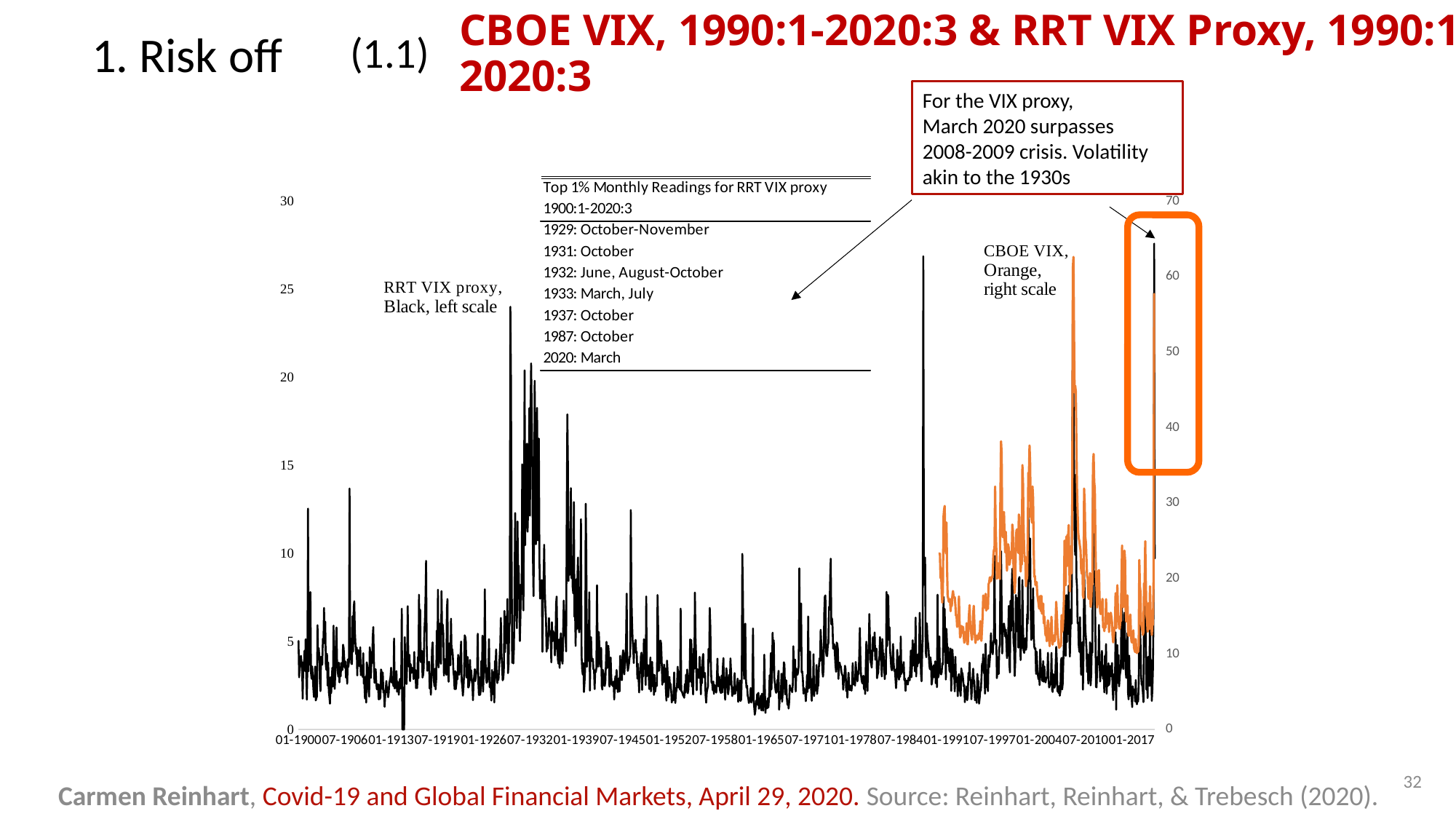
What is the highest tick value shown on the left axis? 30 Which series is plotted in orange on the right scale? CBOE VIX Which is larger for the RRT VIX proxy: its peak in the early 1930s or its peak in the 1950s? early 1930s Is the peak of the CBOE VIX during the 2008-2009 crisis greater or less than 40 on the right scale? greater Does the RRT VIX proxy rise or fall from its early-1930s peak to the late 1940s? fall Which series is plotted in black on the left scale? RRT VIX proxy What is the highest tick value shown on the right axis? 70 Is the RRT VIX proxy around 1960 greater or less than 15 on the left scale? less What kind of chart is shown on the slide? line chart How many series are plotted on the chart? 2